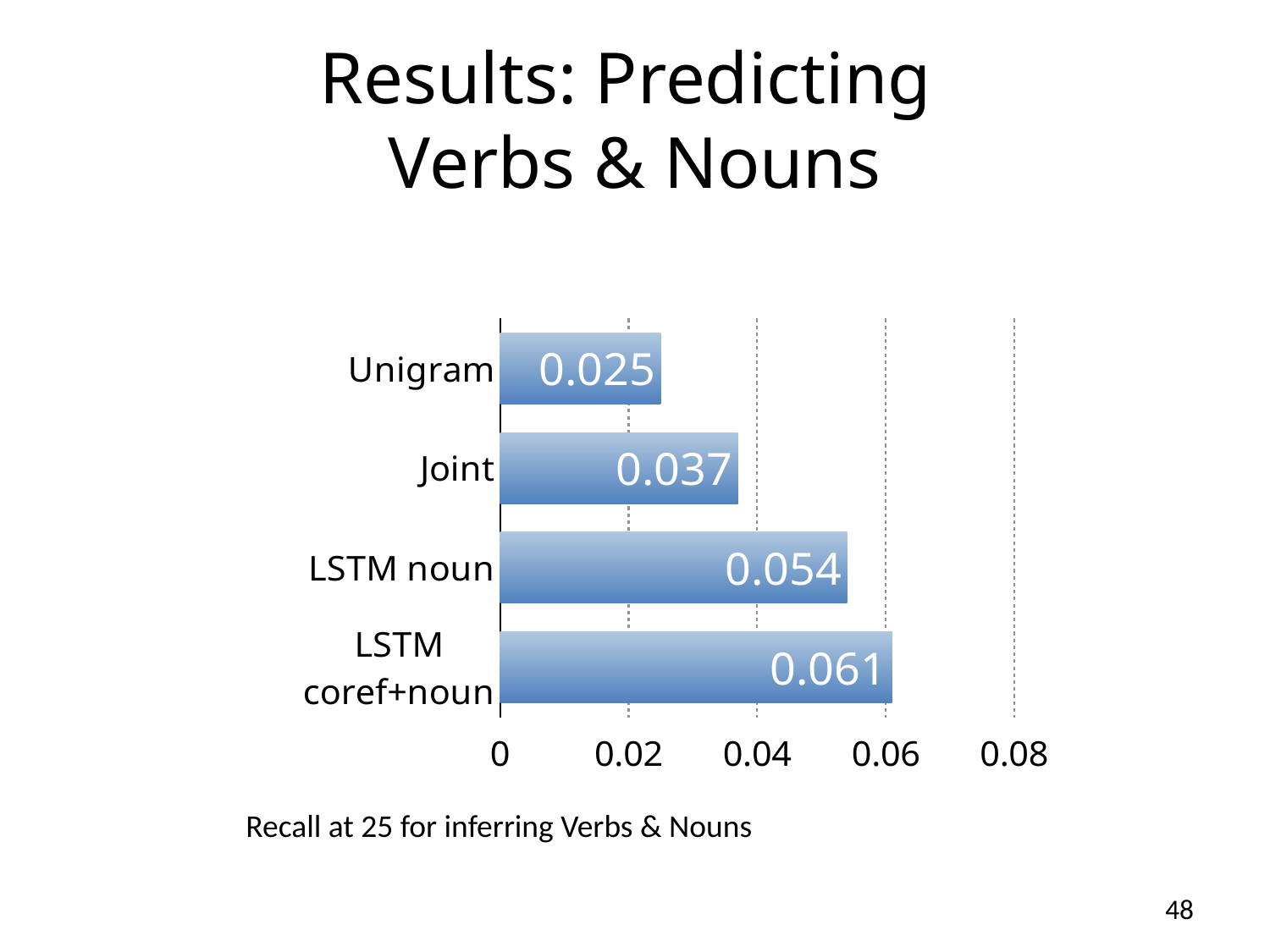
What is the value for Joint? 0.037 Is the value for LSTM coref+noun greater or less than 0.06? greater Which is larger, the value for Joint or the value for LSTM noun? LSTM noun Which category has the lowest value? Unigram What is the value for LSTM noun? 0.054 What is the difference between the values for LSTM coref+noun and Unigram? 0.036 What is the value for Unigram? 0.025 What is the value for LSTM coref+noun? 0.061 What kind of chart is shown on the slide? bar chart Which category has the highest value? LSTM coref+noun How many categories are shown in the chart? 4 What is the difference between the values for LSTM noun and Joint? 0.017